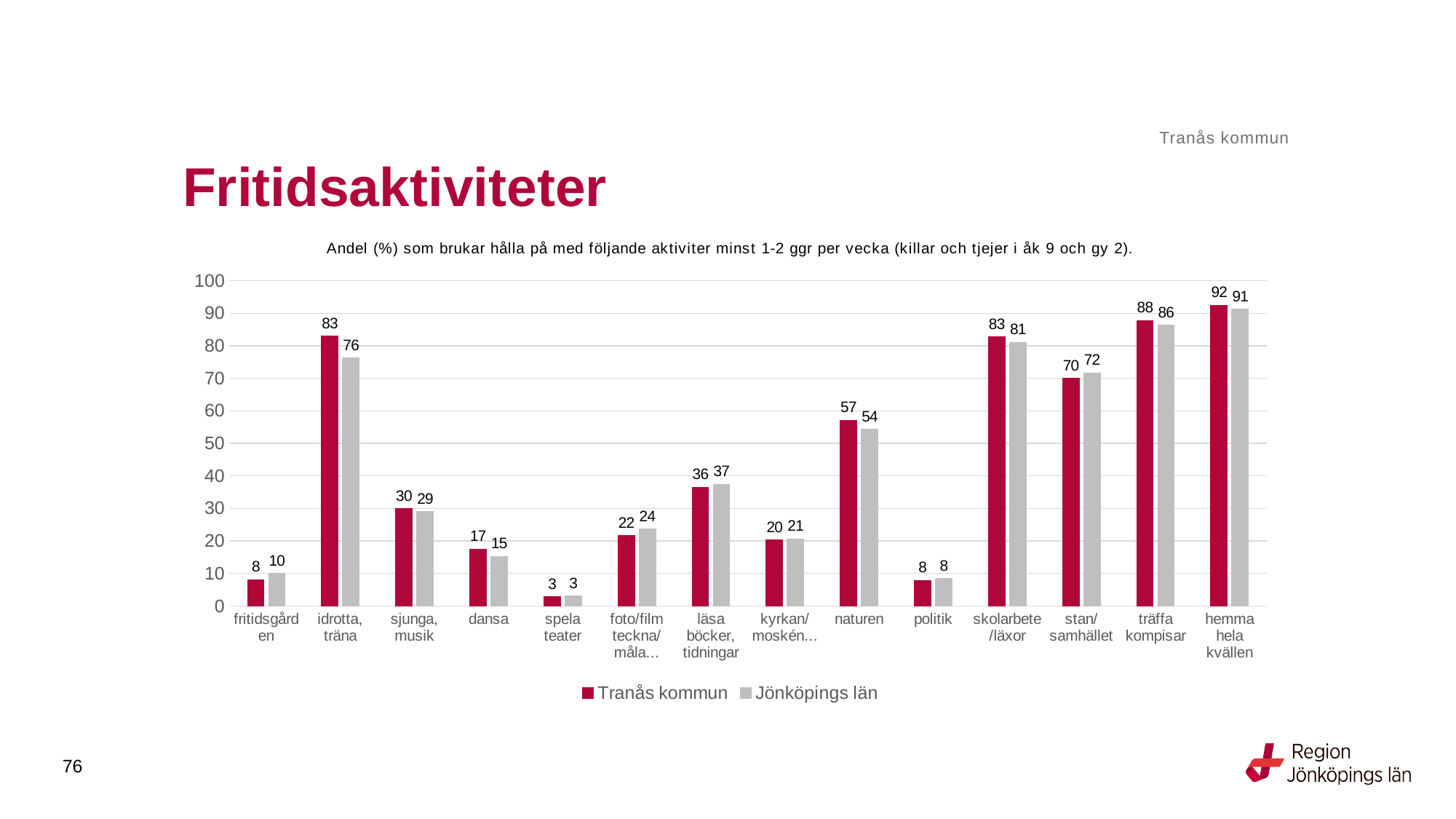
What is the value for Tranås kommun for 'politik'? 8 What colour are the bars for Tranås kommun? red What is the value for Jönköpings län for 'naturen'? 54 Which category has the highest value for Tranås kommun? hemma hela kvällen What is the difference between Tranås kommun and Jönköpings län for 'idrotta, träna'? 7 What kind of chart is shown on the slide? bar chart What is the value for Tranås kommun for 'idrotta, träna'? 83 Which is larger for 'stan/samhället': Tranås kommun or Jönköpings län? Jönköpings län How many activity categories are shown on the x axis? 14 How many series does the legend list? 2 Which category has the lowest value for Jönköpings län? spela teater Is the value for Tranås kommun for 'träffa kompisar' greater or less than 80? greater